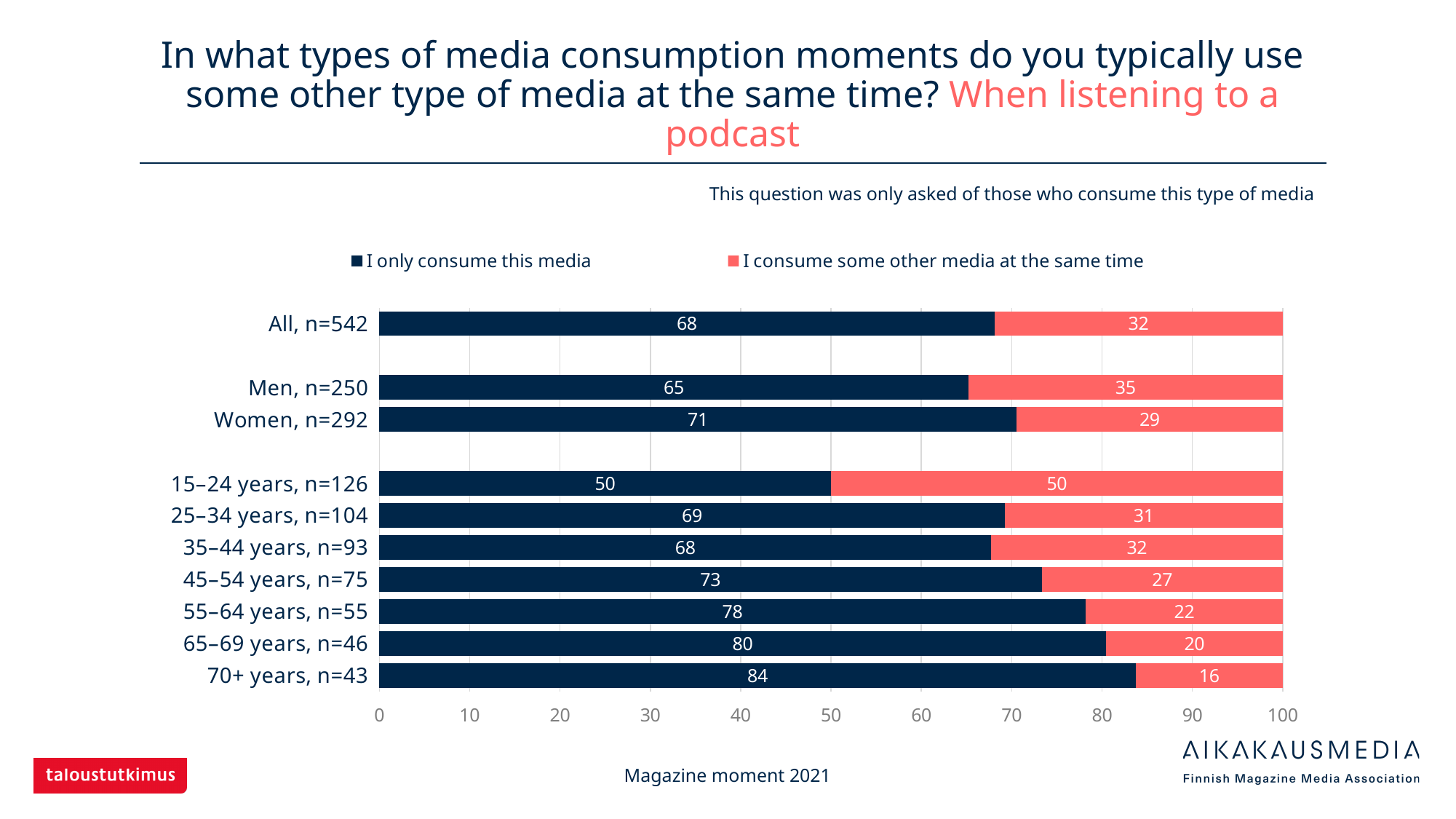
How many series does the legend list? 2 Which category has the highest value for "I only consume this media"? 70+ years, n=43 Which category has the lowest value for "I consume some other media at the same time"? 70+ years, n=43 Which colour represents "I consume some other media at the same time" in the legend? Red (coral) What is the total of the stacked bar for 45–54 years, n=75? 100 How many categories are shown on the chart? 10 What is the value of "I consume some other media at the same time" for Men, n=250? 35 What is the value of "I only consume this media" for All, n=542? 68 What is the difference between the "I only consume this media" values for Women, n=292 and Men, n=250? 6 Which has a larger "I consume some other media at the same time" value: 25–34 years, n=104 or 55–64 years, n=55? 25–34 years, n=104 What is the value of "I only consume this media" for 15–24 years, n=126? 50 What kind of chart is shown on the slide? Stacked bar chart